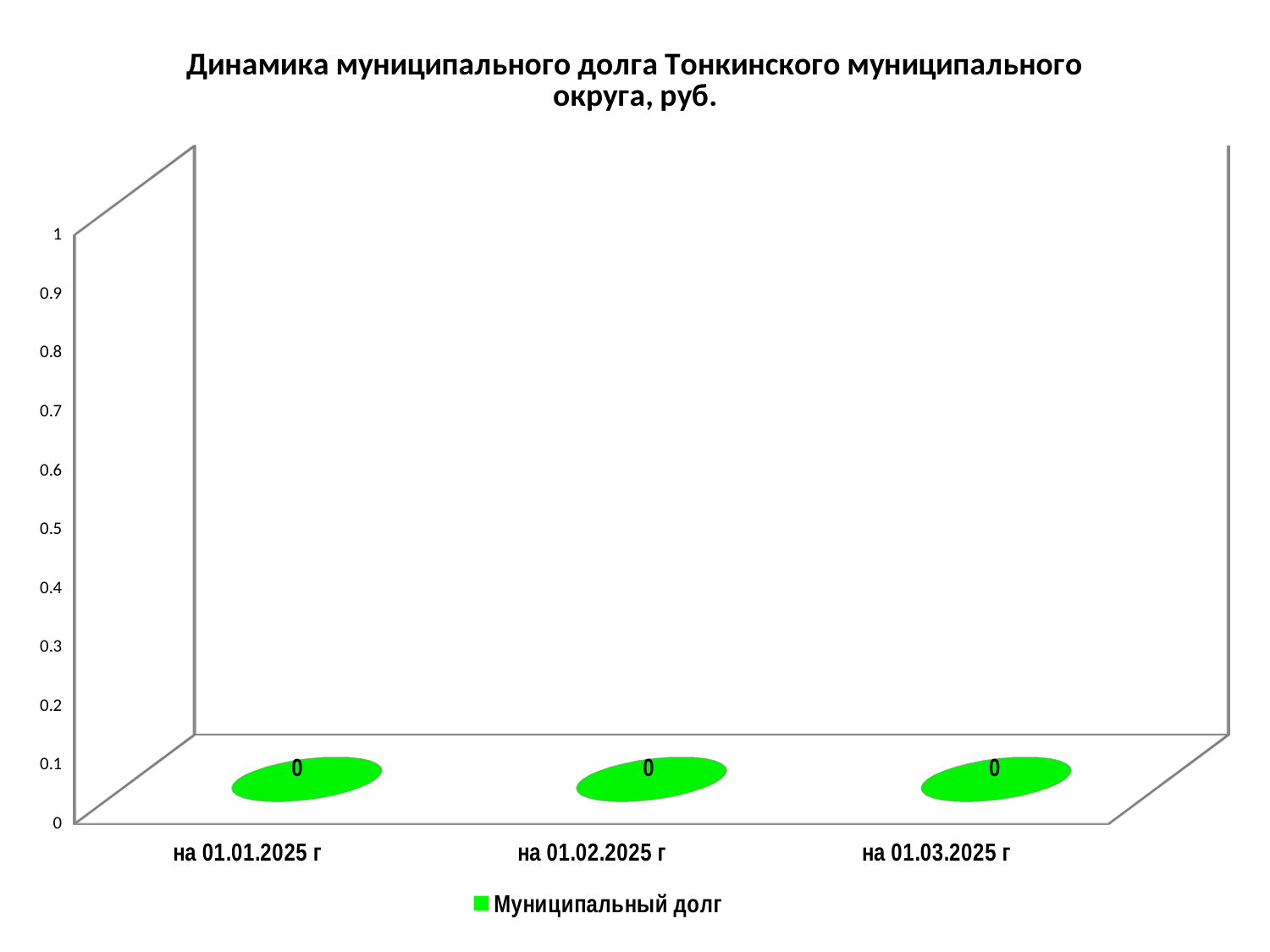
How many series does the legend list? 1 Do the values rise, fall, or stay the same from 01.01.2025 to 01.03.2025? stay the same What is the title of the chart? Динамика муниципального долга Тонкинского муниципального округа, руб. What is the value of Муниципальный долг на 01.02.2025 г? 0 What kind of chart is shown on the slide? bar chart What is the value of Муниципальный долг на 01.03.2025 г? 0 What is the difference between the values на 01.03.2025 г and на 01.01.2025 г? 0 What series name is shown in the legend? Муниципальный долг What is the value of Муниципальный долг на 01.01.2025 г? 0 How many dates (categories) are shown on the x axis? 3 Is the value на 01.02.2025 г greater or less than 0.5? less